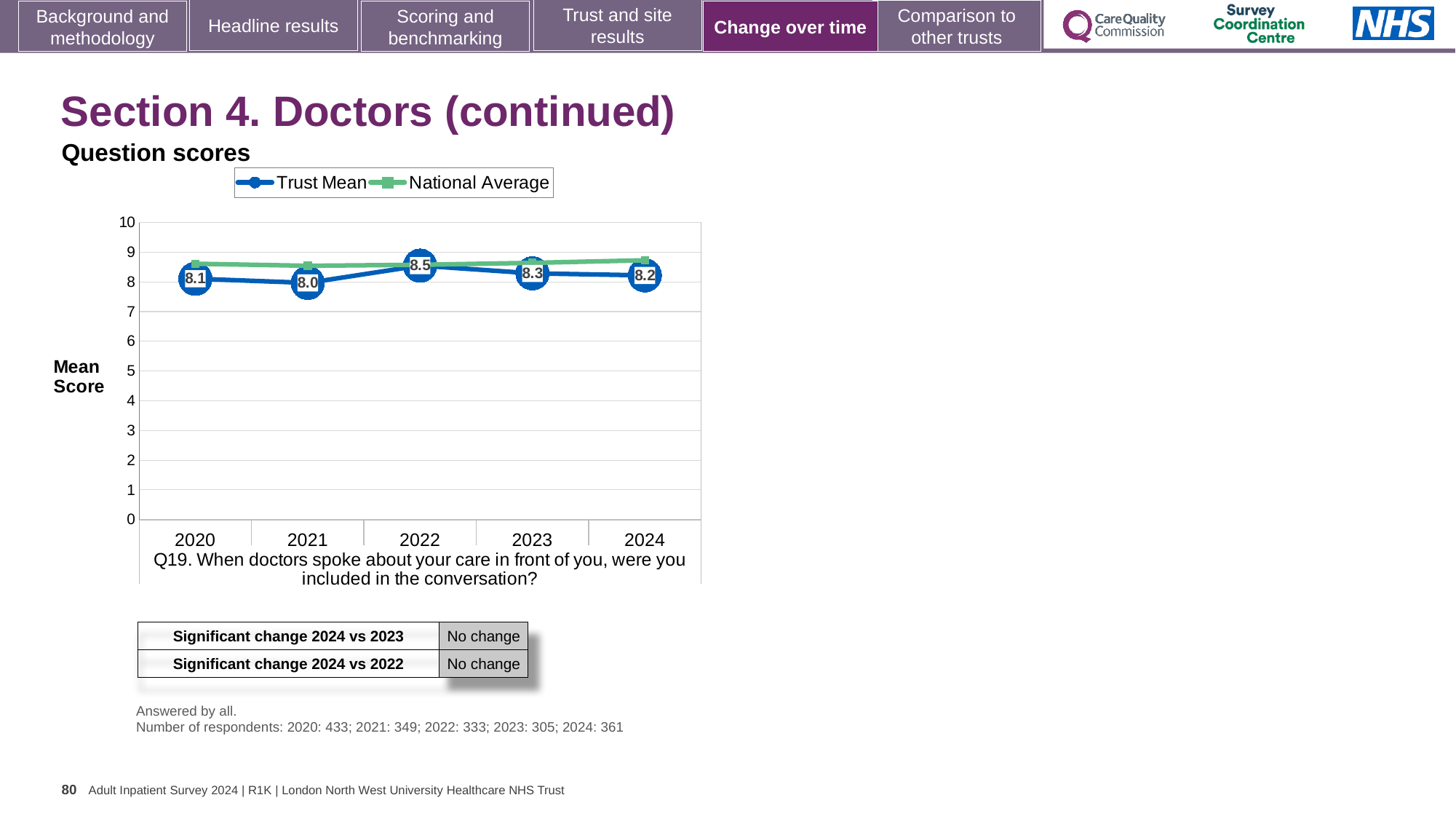
In which year is the Trust Mean highest? 2022 What is the difference between the Trust Mean in 2022 and in 2021? 0.5 Which is larger, the Trust Mean in 2020 or in 2023? 2023 How many years are plotted on the x axis? 5 How many series does the legend list? 2 Is the National Average for 2024 greater or less than 8? greater What is the Trust Mean score for 2022? 8.5 What is the Trust Mean score for 2021? 8.0 What kind of chart is shown? line chart Which series is drawn in green? National Average What is the Trust Mean score for 2024? 8.2 In which year is the Trust Mean lowest? 2021